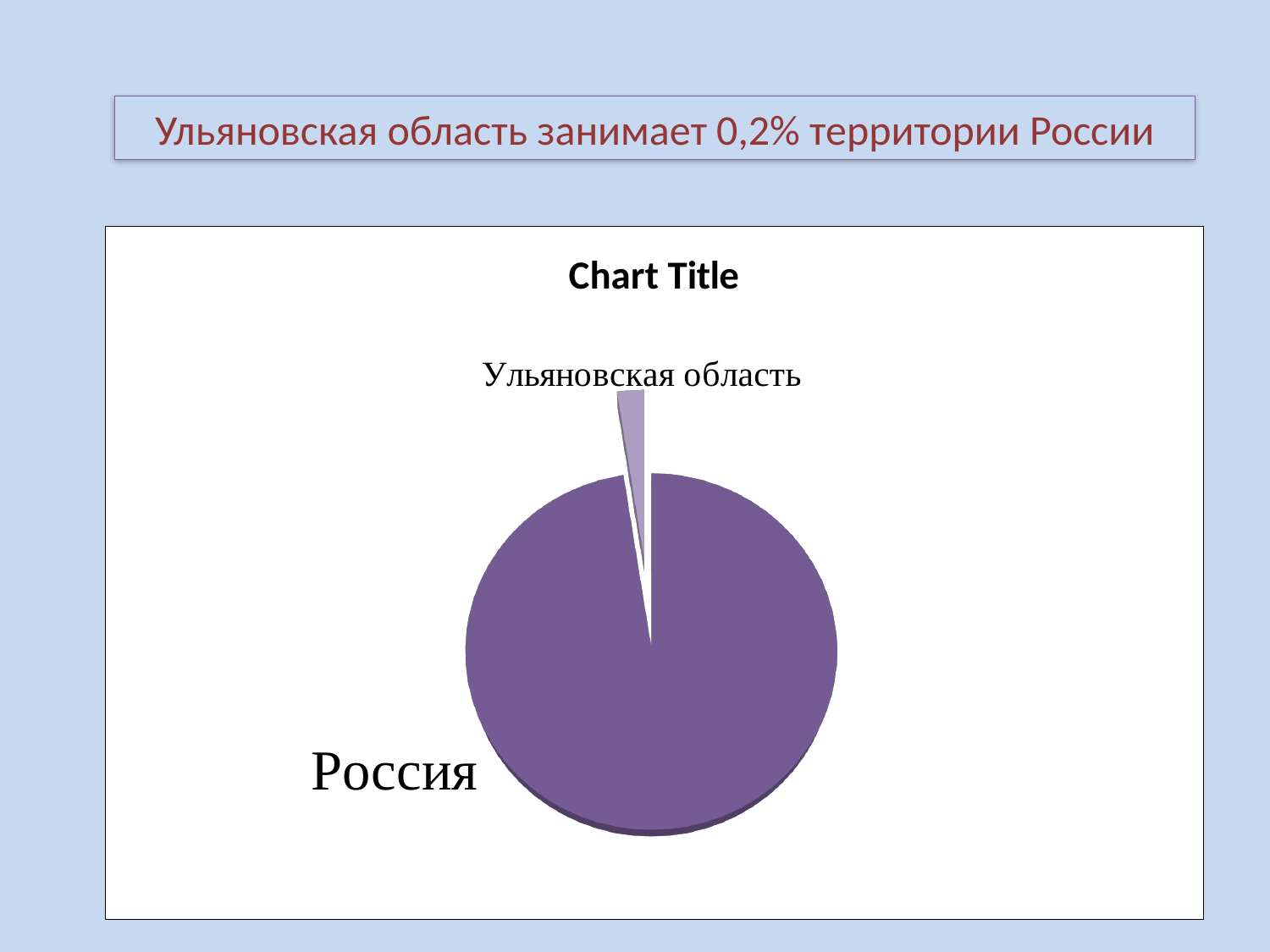
Which slice of the pie chart is pulled out (separated) from the rest of the pie? Ульяновская область What is the title shown above the pie chart? Chart Title What kind of chart is shown on the slide? pie chart Which slice of the pie chart is the smallest? Ульяновская область Which is larger in the pie chart, the slice for Россия or the slice for Ульяновская область? Россия Which slice of the pie chart is the largest? Россия How many slices does the pie chart have? 2